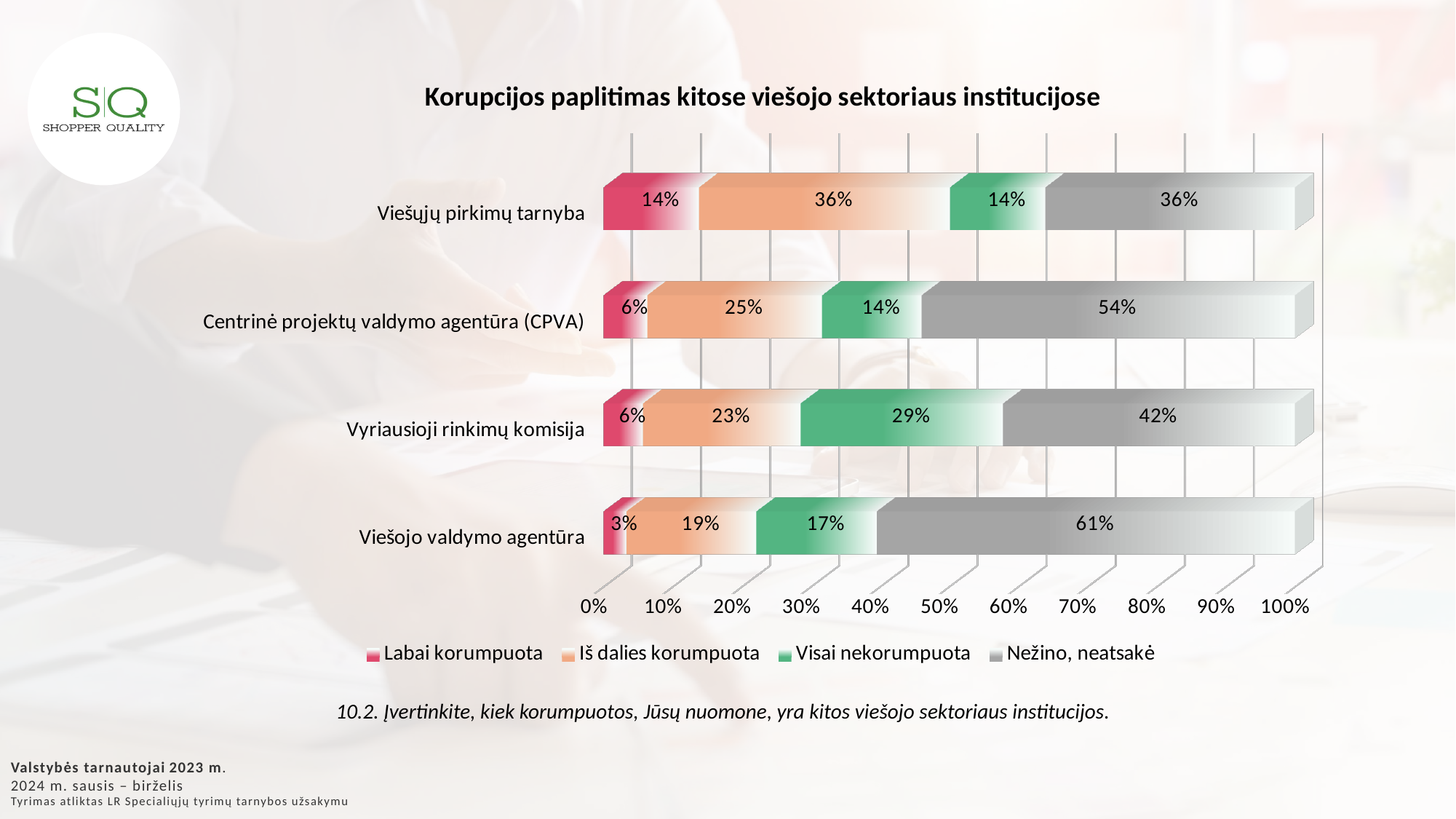
What is the difference between the "Nežino, neatsakė" values for Viešojo valdymo agentūra and Vyriausioji rinkimų komisija? 19% What is the "Nežino, neatsakė" value for Viešojo valdymo agentūra? 61% What is the "Visai nekorumpuota" value for Vyriausioji rinkimų komisija? 29% What percentage of respondents rated Viešųjų pirkimų tarnyba as "Labai korumpuota"? 14% Which institution has the lowest "Nežino, neatsakė" share? Viešųjų pirkimų tarnyba Which is larger: the "Visai nekorumpuota" value for Vyriausioji rinkimų komisija or for Viešojo valdymo agentūra? Vyriausioji rinkimų komisija How many series does the legend list? 4 How many institutions are shown in the chart? 4 What type of chart is shown on the slide? Stacked bar chart Which institution has the highest "Labai korumpuota" share? Viešųjų pirkimų tarnyba What is the title of the chart? Korupcijos paplitimas kitose viešojo sektoriaus institucijose What is the "Iš dalies korumpuota" value for Centrinė projektų valdymo agentūra (CPVA)? 25%